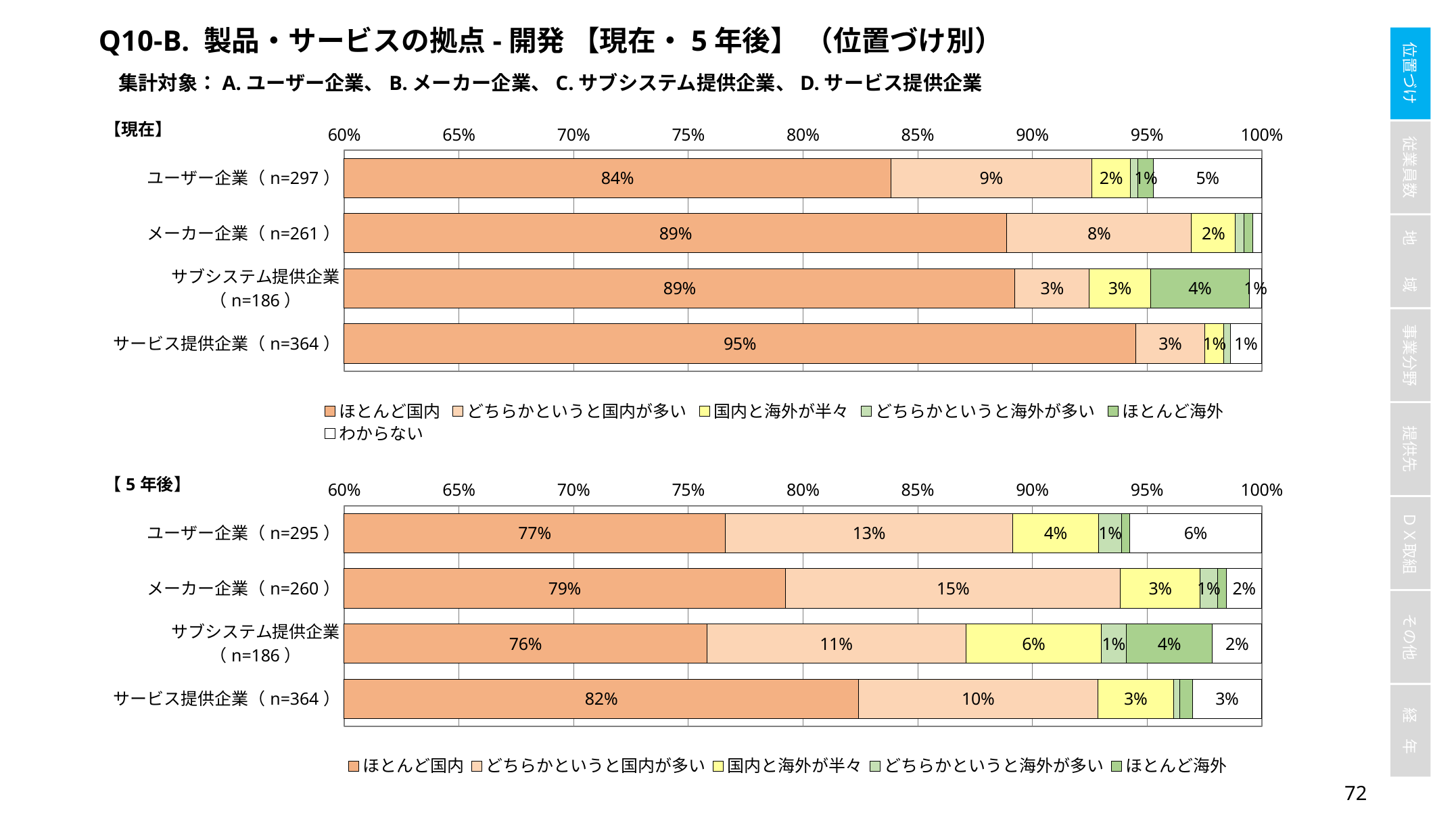
In the 【5年後】 chart, what percentage of メーカー企業 answered どちらかというと国内が多い? 15% In the 【現在】 chart, which category has the highest share of ほとんど国内? サービス提供企業 In the 【5年後】 chart, which category has the lowest share of ほとんど国内? サブシステム提供企業 How many categories (company types) are shown in the 【現在】 chart? 4 What kind of chart is the 【5年後】 chart? Stacked horizontal bar chart How many percentage points higher is the ほとんど国内 share for ユーザー企業 in the 【現在】 chart than in the 【5年後】 chart? 7 percentage points How many series does the legend of the 【5年後】 chart list? 5 In the 【5年後】 chart, which has the larger どちらかというと国内が多い share: ユーザー企業 or メーカー企業? メーカー企業 In the 【5年後】 chart, what percentage of サブシステム提供企業 answered ほとんど海外? 4% In the 【現在】 chart, what percentage of ユーザー企業 answered ほとんど国内? 84% At what value does the x axis of the 【現在】 chart start? 60% How many series does the legend of the 【現在】 chart list? 6